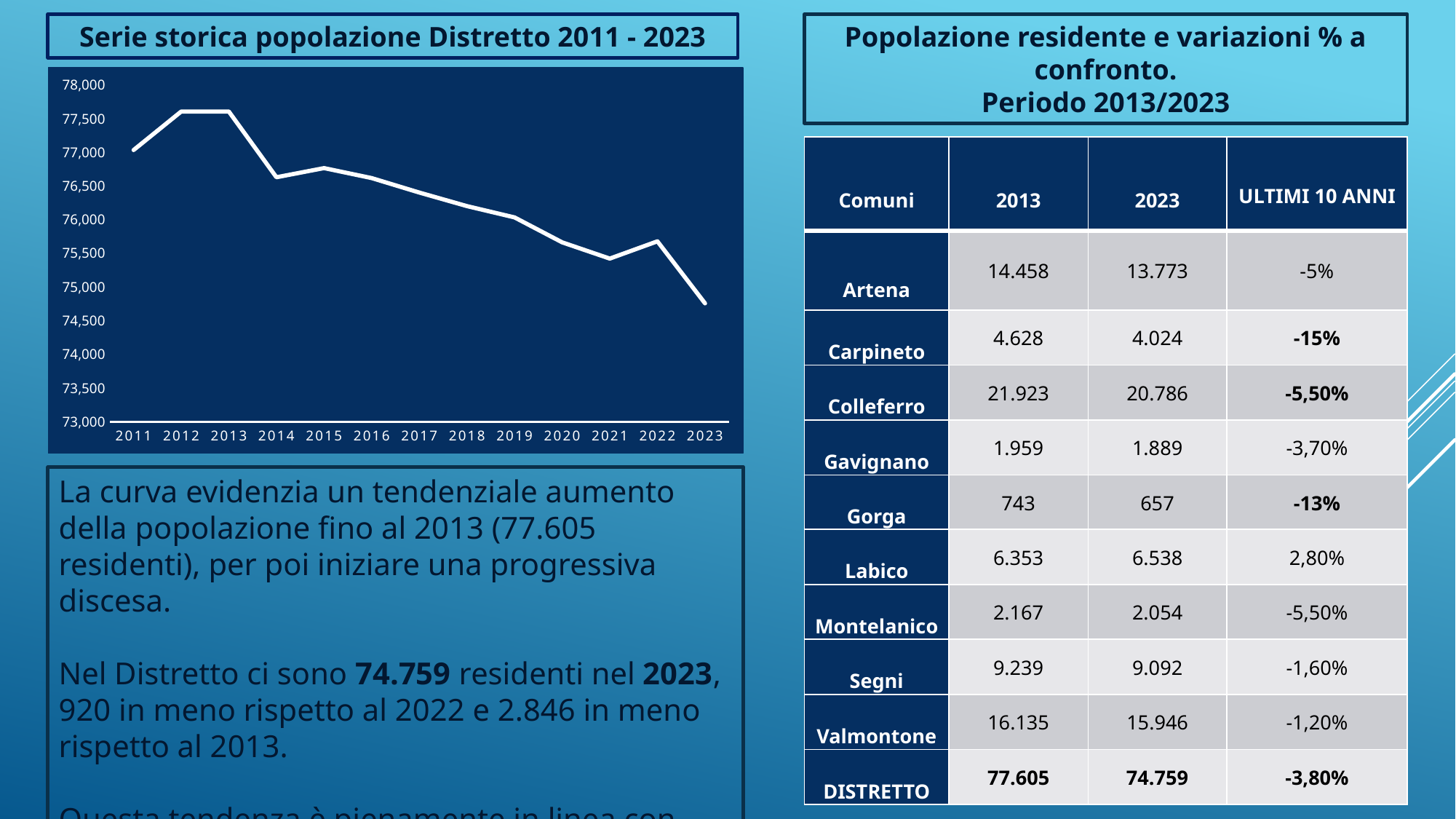
How many years are plotted on the x axis of the chart? 13 Which year has the larger population value, 2021 or 2022? 2022 Is the value for 2023 greater or less than 75,000? less Which year has the lowest population value in the chart? 2023 Overall, does the population in the chart rise or fall from 2013 to 2023? fall Is the value for 2012 greater or less than 77,500? greater Is the value for 2015 greater or less than 76,500? greater What is the title of the chart on the slide? Serie storica popolazione Distretto 2011 - 2023 What kind of chart is shown on the slide? line chart Which year has the larger population value, 2015 or 2021? 2015